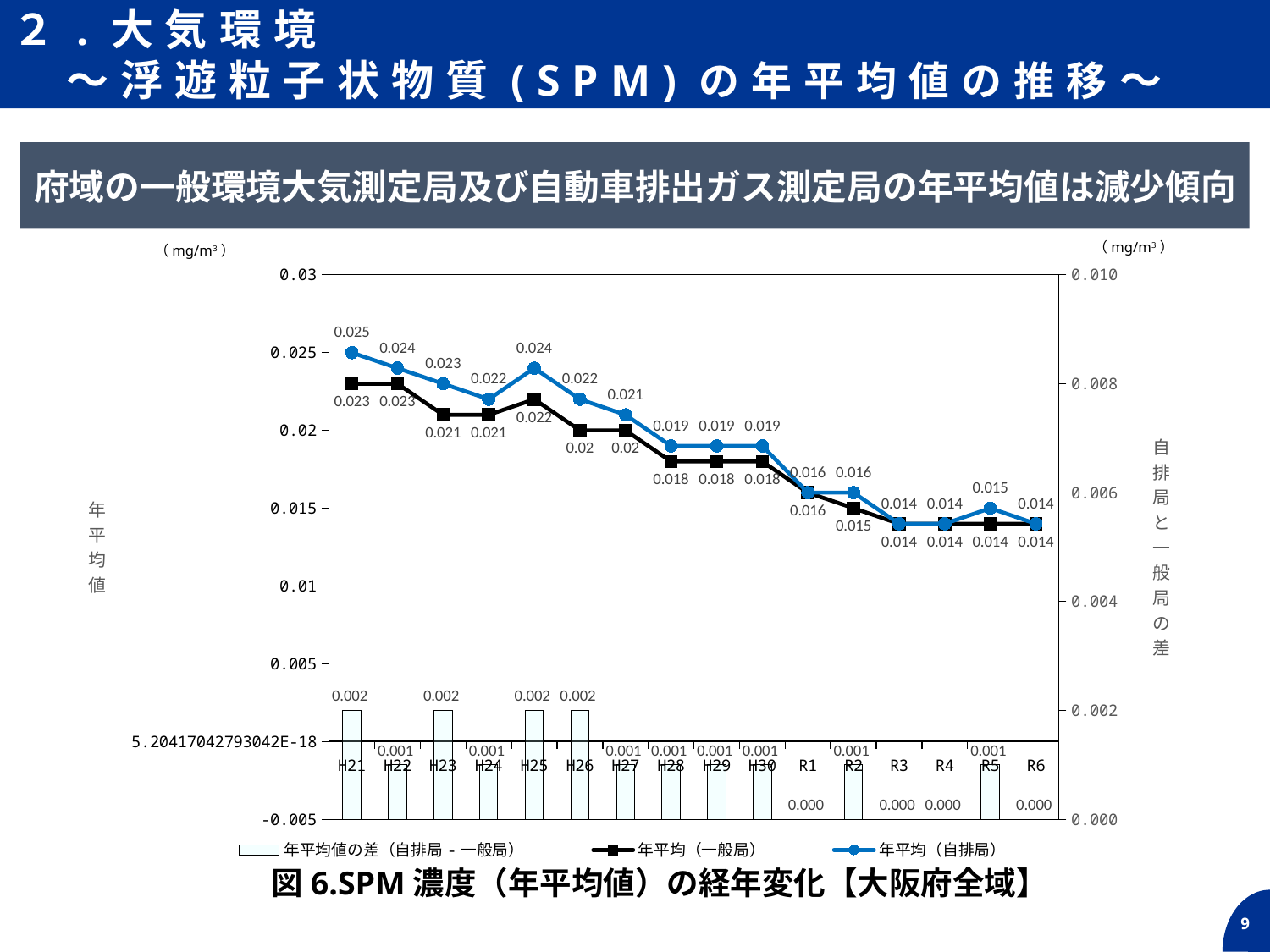
図6のグラフで、H21の年平均（自排局）の値はいくつですか？ 0.025 図6のグラフで、年平均（自排局）の線は何色ですか？ 青 図6のグラフで、H25の年平均（一般局）の値はいくつですか？ 0.022 図6のグラフの凡例には何系列ありますか？ 3 図6のグラフで、H28の年平均（一般局）の値は0.02より大きいですか、小さいですか？ 小さい 図6のグラフで、R5の年平均（自排局）の値はいくつですか？ 0.015 図6のグラフで、H23の年平均値の差（自排局－一般局）はいくつですか？ 0.002 図6のグラフの横軸には何年度分のデータがありますか？ 16 図6のグラフで、H25の年平均（自排局）とH26の年平均（自排局）ではどちらが大きいですか？ H25 図6のグラフで、H21の年平均（自排局）と年平均（一般局）の差はいくつですか？ 0.002 図6のグラフで、年平均（自排局）が最も高いのはどの年度ですか？ H21 図6のグラフで、年平均（自排局）はH21からR6にかけて全体として上昇していますか、下降していますか？ 下降